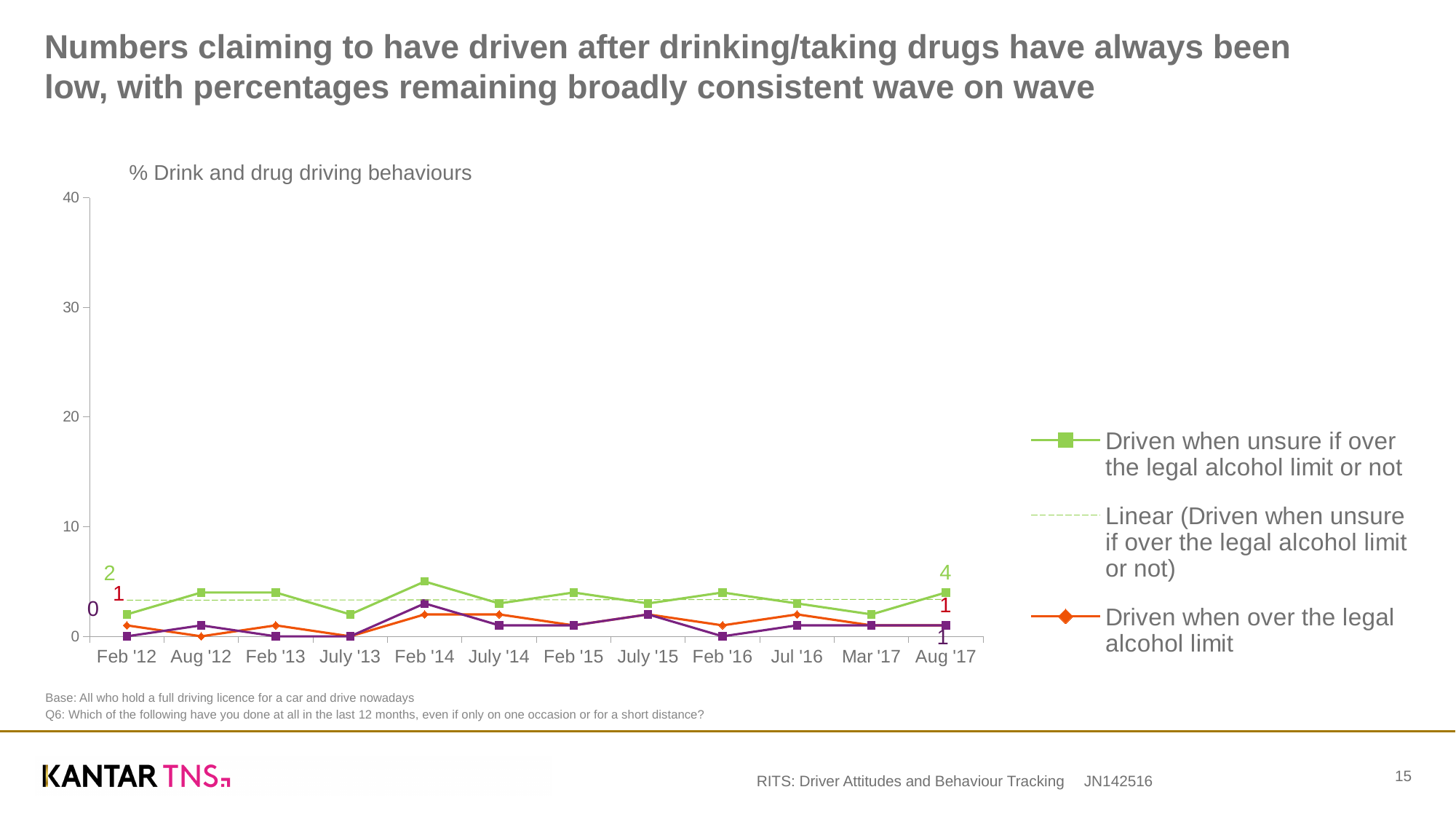
How many entries does the chart's legend list? 3 Does the 'Driven when unsure if over the legal alcohol limit or not' series end higher or lower in Aug '17 than it started in Feb '12? higher What is the value for 'Driven when over the legal alcohol limit' in Feb '12? 1 What is the value for 'Driven when unsure if over the legal alcohol limit or not' in Aug '17? 4 What is the value for 'Driven when over the legal alcohol limit' in Aug '17? 1 What is the value for 'Driven when unsure if over the legal alcohol limit or not' in Feb '12? 2 What is the title of the chart? % Drink and drug driving behaviours What kind of chart is shown on the slide? line chart Is the value for 'Driven when unsure if over the legal alcohol limit or not' in Feb '14 greater or less than 10? less How many time points are plotted along the x axis of the chart? 12 For 'Driven when unsure if over the legal alcohol limit or not', which is larger: the Feb '12 value or the Aug '17 value? Aug '17 By how much did the value for 'Driven when unsure if over the legal alcohol limit or not' change between Feb '12 and Aug '17? 2